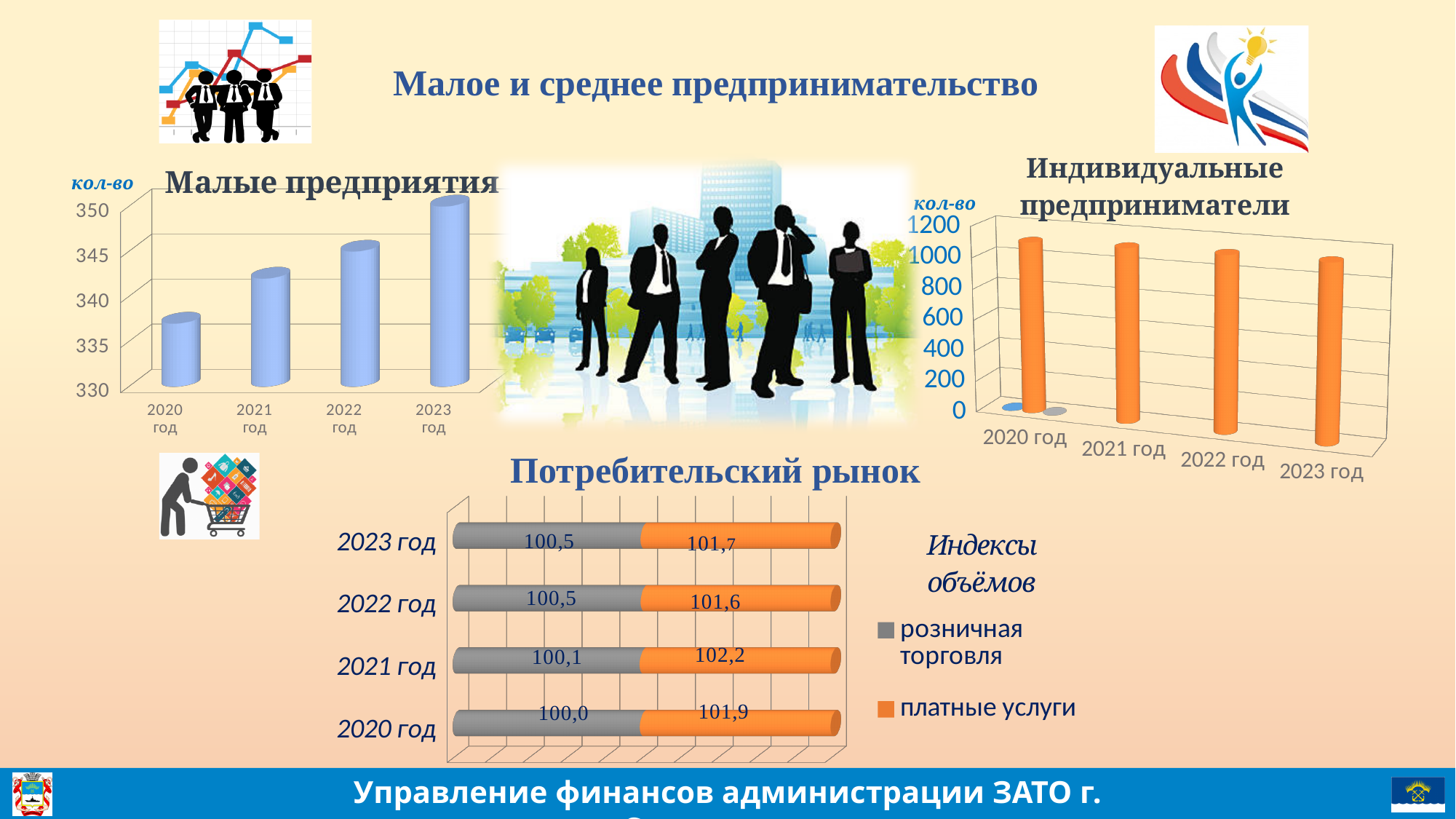
On the 'Потребительский рынок' chart, which year has the highest value for платные услуги? 2021 год On the 'Малые предприятия' chart, do the values rise or fall from 2020 год to 2023 год? rise On the 'Потребительский рынок' chart, what is the value for платные услуги in 2021 год? 102,2 On the 'Потребительский рынок' chart, what is the value for розничная торговля in 2023 год? 100,5 On the 'Потребительский рынок' chart, what is the total of the stacked bar for 2023 год? 202,2 On the 'Малые предприятия' chart, is the value for 2020 год greater or less than 340? less On the 'Потребительский рынок' chart, what is the difference between платные услуги and розничная торговля in 2021 год? 2,1 What kind of chart is the 'Малые предприятия' chart? bar chart How many series does the legend of the 'Потребительский рынок' chart list? 2 On the 'Индивидуальные предприниматели' chart, is the value for 2020 год greater or less than 1000? greater On the 'Потребительский рынок' chart, which is larger: платные услуги in 2021 год or платные услуги in 2022 год? 2021 год